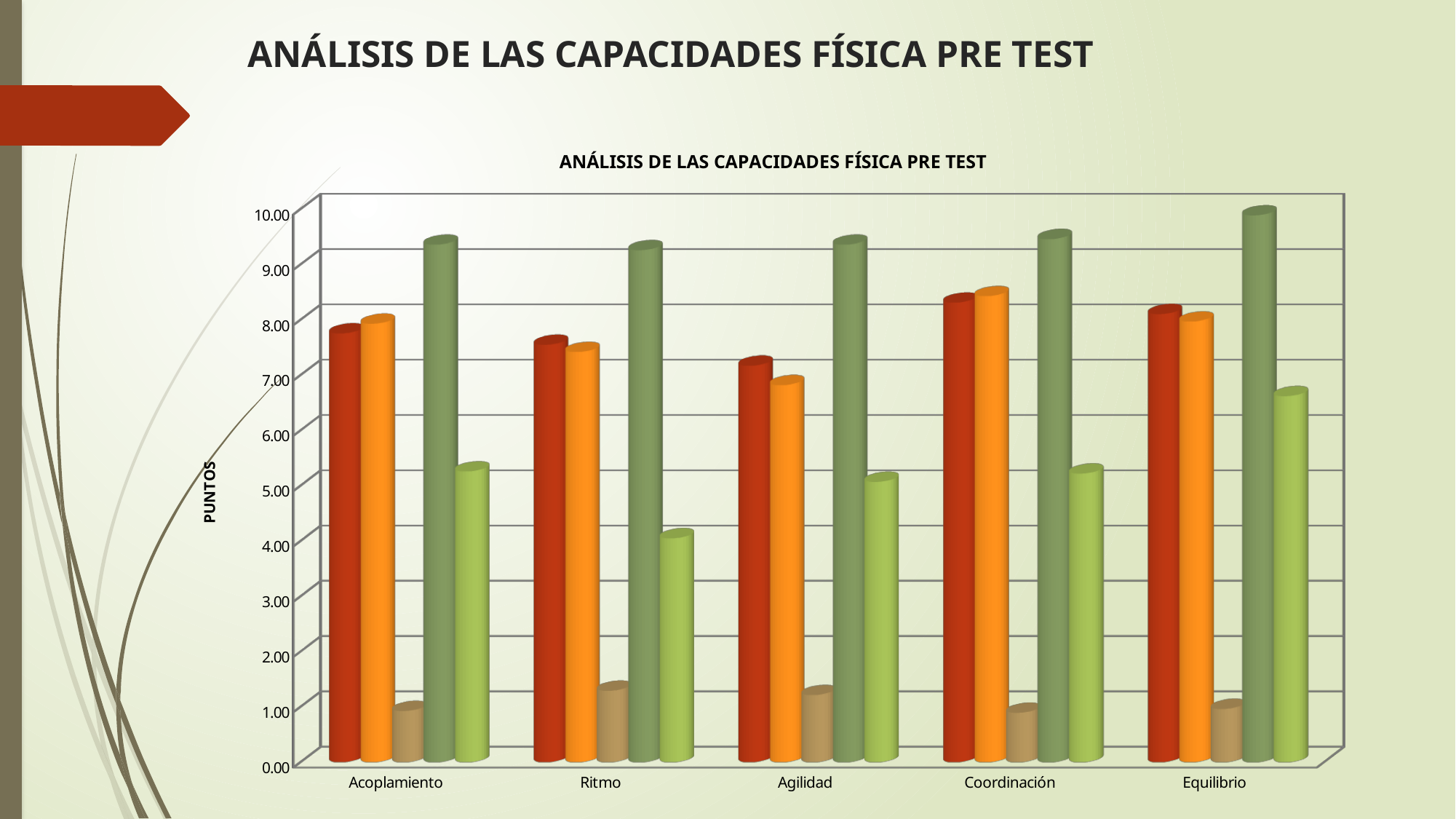
Is the value of the tan bar for Acoplamiento greater or less than 2.00? less Is the value of the dark red bar for Coordinación greater or less than 8.00? greater What is the label on the vertical axis of the chart? PUNTOS Is the value of the light green bar for Ritmo greater or less than 5.00? less How many categories are shown on the x axis of the chart? 5 How many bars are plotted for each category in the chart? 5 What kind of chart is shown on the slide? bar chart Which is larger, the light green bar for Equilibrio or the light green bar for Ritmo? Equilibrio Which category has the lowest light green bar? Ritmo What is the title of the chart? ANÁLISIS DE LAS CAPACIDADES FÍSICA PRE TEST